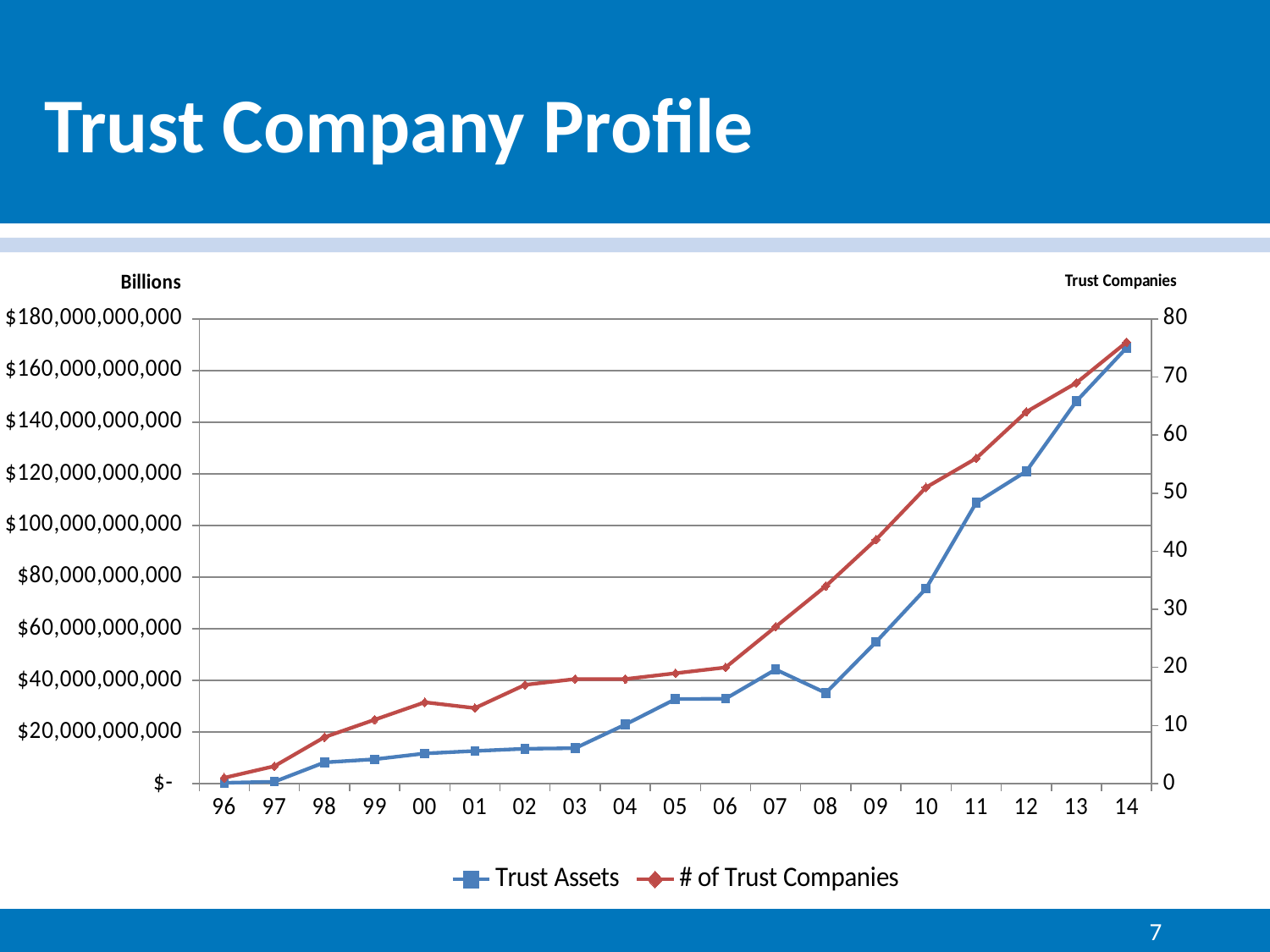
Which year has the highest value for Trust Assets? 14 Is the value for # of Trust Companies in 02 greater or less than 20? less How many series does the legend list? 2 Which year has the lowest value for # of Trust Companies? 96 What is the label shown above the right-hand axis? Trust Companies What kind of chart is shown on the slide? line chart Is the value for # of Trust Companies in 14 greater or less than 70? greater Which is larger, the Trust Assets value in 07 or in 08? 07 How many years are plotted along the x axis? 19 Is the value for Trust Assets in 05 greater or less than $40,000,000,000? less Do the values for # of Trust Companies generally rise or fall from 96 to 14? rise